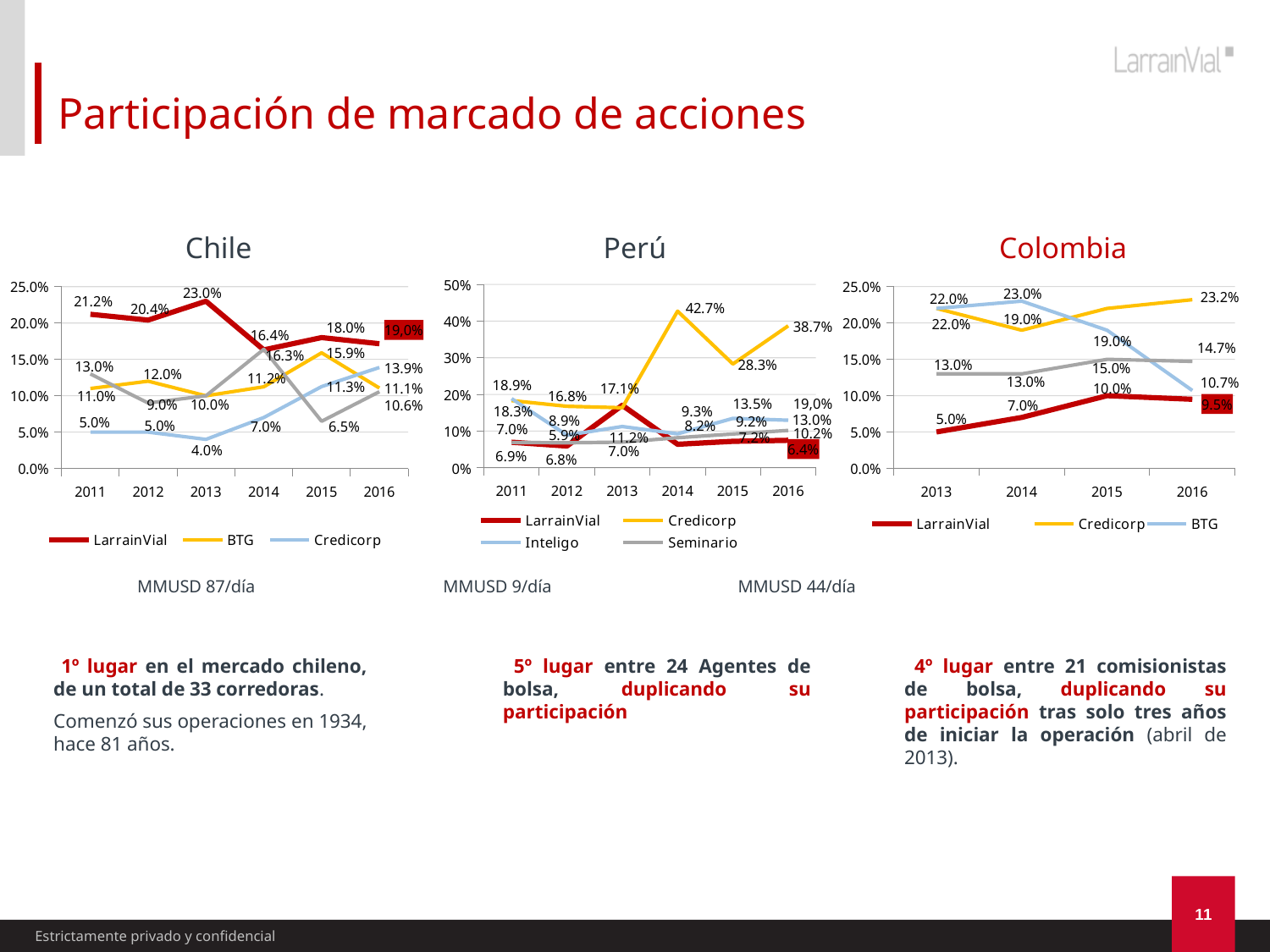
What kind of chart is the Chile chart? Line chart How many series does the legend of the Chile chart list? 3 In the Chile chart, what was Credicorp's market share in 2013? 4.0% In the Perú chart, what was Credicorp's market share in 2014? 42.7% How many years are shown on the x axis of the Colombia chart? 4 In the Chile chart, what was LarrainVial's market share in 2013? 23.0% In the Chile chart, in which year did LarrainVial reach its highest market share? 2013 In the Colombia chart, by how many percentage points did LarrainVial's share increase from 2013 to 2015? 5.0 percentage points In the Perú chart, in which year did Credicorp have its highest market share? 2014 In the Colombia chart, which had the larger market share in 2016, Credicorp or BTG? Credicorp How many series does the legend of the Perú chart list? 4 In the Colombia chart, what was LarrainVial's market share in 2013? 5.0%